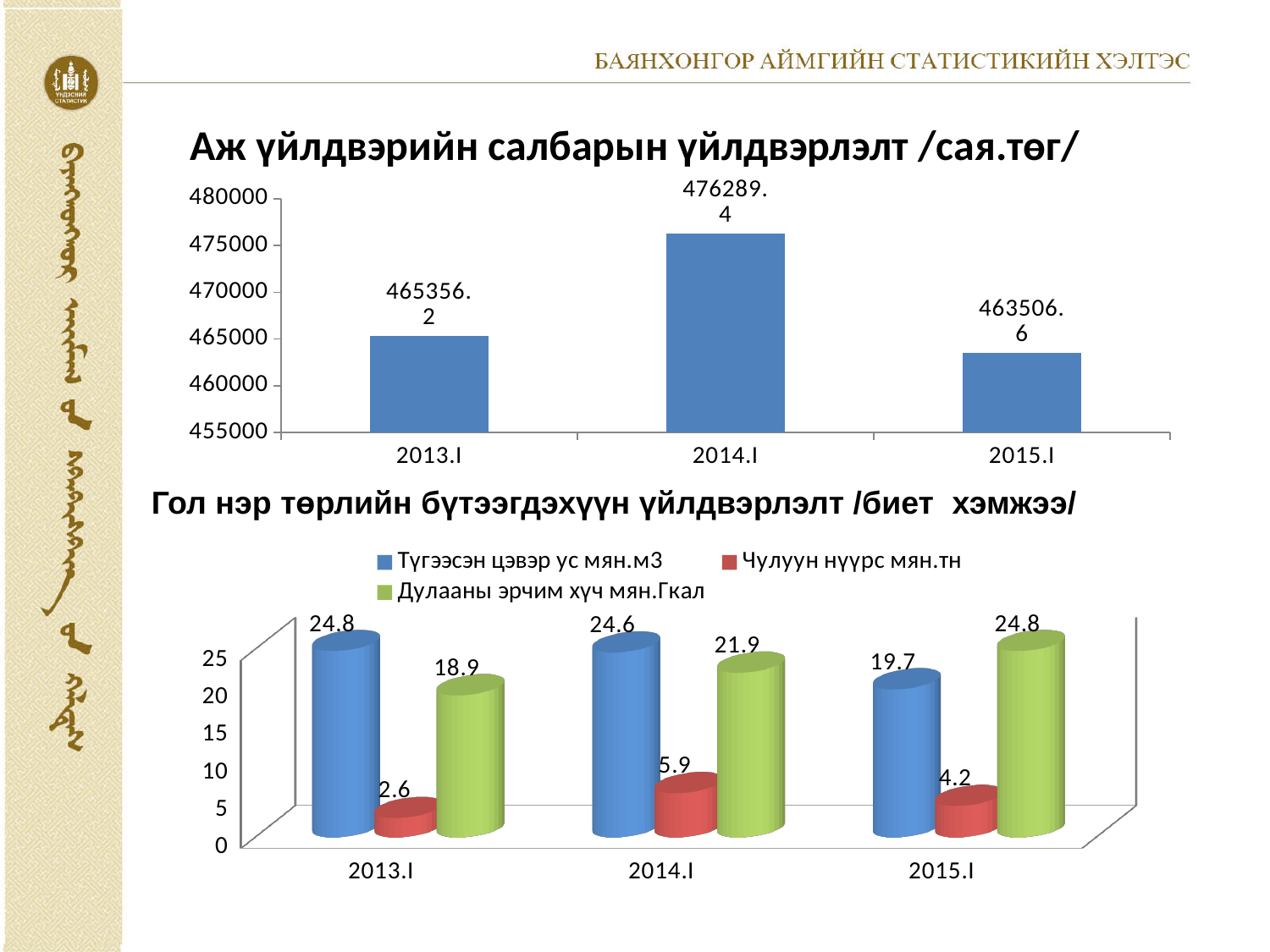
In the top chart (Аж үйлдвэрийн салбарын үйлдвэрлэлт), how many periods are shown on the x axis? 3 In the bottom chart (Гол нэр төрлийн бүтээгдэхүүн үйлдвэрлэлт), what is the value of Дулааны эрчим хүч мян.Гкал for 2015.I? 24.8 In the top chart (Аж үйлдвэрийн салбарын үйлдвэрлэлт), what is the value for 2014.I? 476289.4 In the top chart (Аж үйлдвэрийн салбарын үйлдвэрлэлт), is the value for 2013.I greater or less than 470000? less In the bottom chart (Гол нэр төрлийн бүтээгдэхүүн үйлдвэрлэлт), does the value of Дулааны эрчим хүч мян.Гкал rise or fall from 2013.I to 2015.I? rise In the bottom chart (Гол нэр төрлийн бүтээгдэхүүн үйлдвэрлэлт), what is the value of Чулуун нүүрс мян.тн for 2014.I? 5.9 In the bottom chart (Гол нэр төрлийн бүтээгдэхүүн үйлдвэрлэлт), what is the difference between Түгээсэн цэвэр ус мян.м3 in 2013.I and 2015.I? 5.1 In the top chart (Аж үйлдвэрийн салбарын үйлдвэрлэлт), which period has the lowest value? 2015.I What kind of chart is the bottom chart (Гол нэр төрлийн бүтээгдэхүүн үйлдвэрлэлт)? bar chart In the bottom chart (Гол нэр төрлийн бүтээгдэхүүн үйлдвэрлэлт), how many series does the legend list? 3 In the top chart (Аж үйлдвэрийн салбарын үйлдвэрлэлт), what is the difference between the 2014.I and 2013.I values? 10933.2 In the bottom chart (Гол нэр төрлийн бүтээгдэхүүн үйлдвэрлэлт), which is larger for 2015.I: Түгээсэн цэвэр ус мян.м3 or Дулааны эрчим хүч мян.Гкал? Дулааны эрчим хүч мян.Гкал